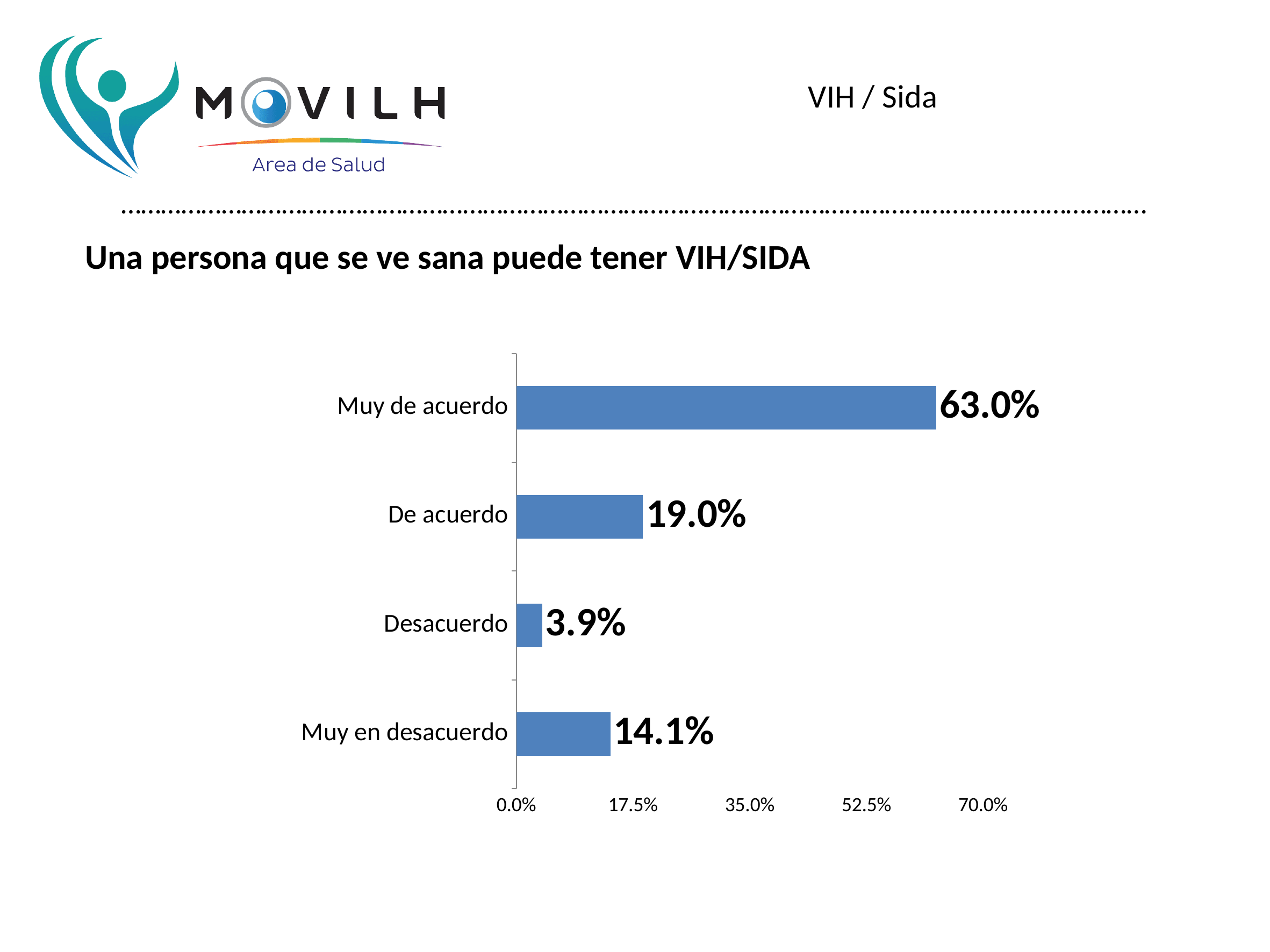
How many response categories are shown in the chart? 4 What kind of chart is shown on the slide? Bar chart Which response category has the lowest value? Desacuerdo Is the value for "Muy de acuerdo" greater or less than 52.5%? greater What is the value shown for "De acuerdo"? 19.0% What is the difference between the values for "Muy en desacuerdo" and "Desacuerdo"? 10.2% What is the value shown for "Desacuerdo"? 3.9% What is the difference between the values for "Muy de acuerdo" and "De acuerdo"? 44.0% What percentage of respondents answered "Muy de acuerdo"? 63.0% Which is larger, the value for "De acuerdo" or the value for "Muy en desacuerdo"? De acuerdo Which response category has the highest value? Muy de acuerdo What is the value shown for "Muy en desacuerdo"? 14.1%